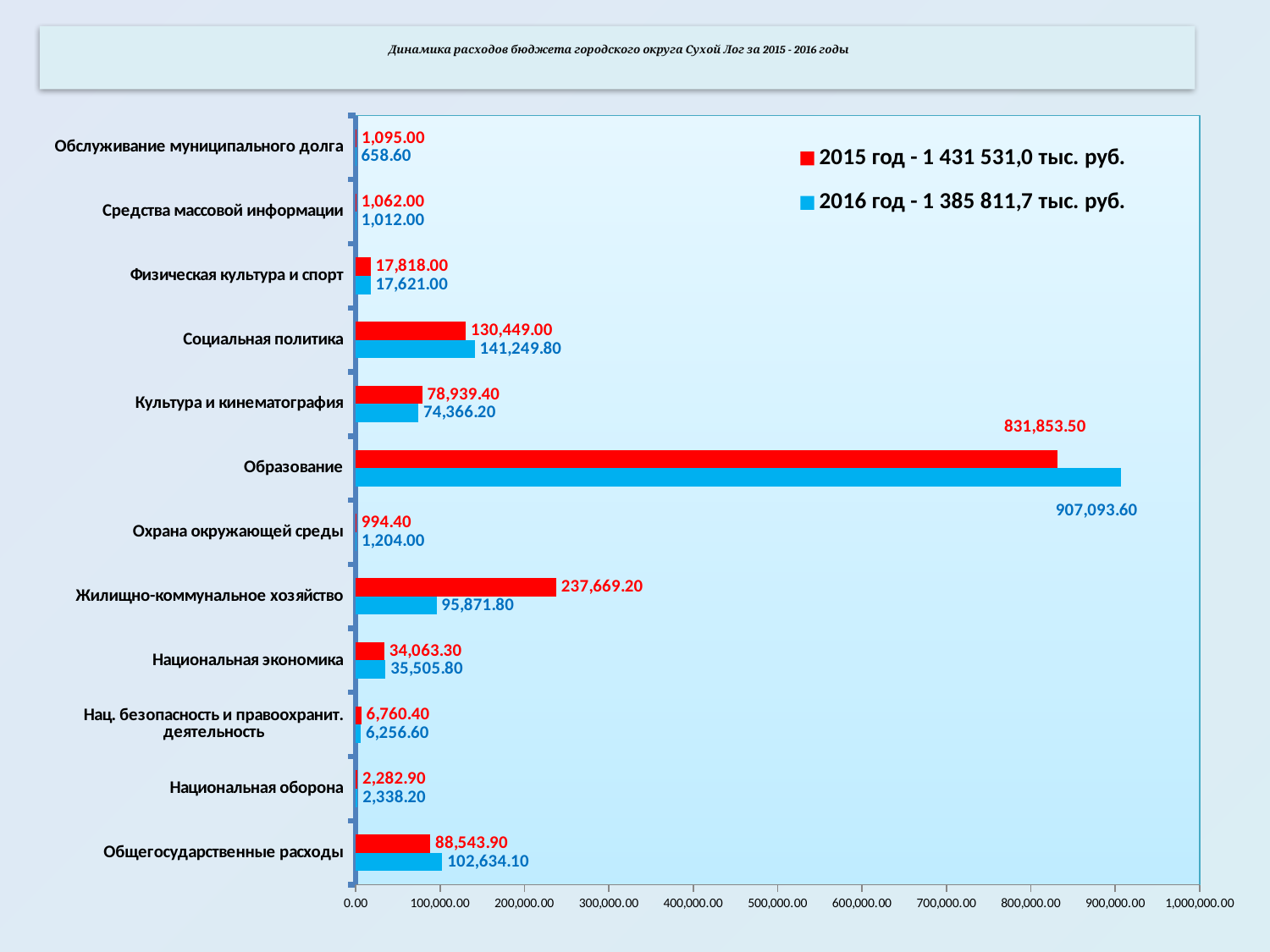
What is the 2016 value for Жилищно-коммунальное хозяйство? 95,871.80 Is the 2016 value for Образование greater or less than 900,000.00? greater Which category has the highest 2016 value? Образование How many categories are shown on the chart? 12 What kind of chart is shown on the slide? bar chart What is the difference between the 2015 and 2016 values for Жилищно-коммунальное хозяйство? 141,797.40 What is the 2016 value for Общегосударственные расходы? 102,634.10 What is the difference between the 2016 and 2015 values for Образование? 75,240.10 How many series does the legend list? 2 Which is larger for Социальная политика, the 2015 value or the 2016 value? 2016 Which category has the lowest 2016 value? Обслуживание муниципального долга What is the 2015 value for Образование? 831,853.50